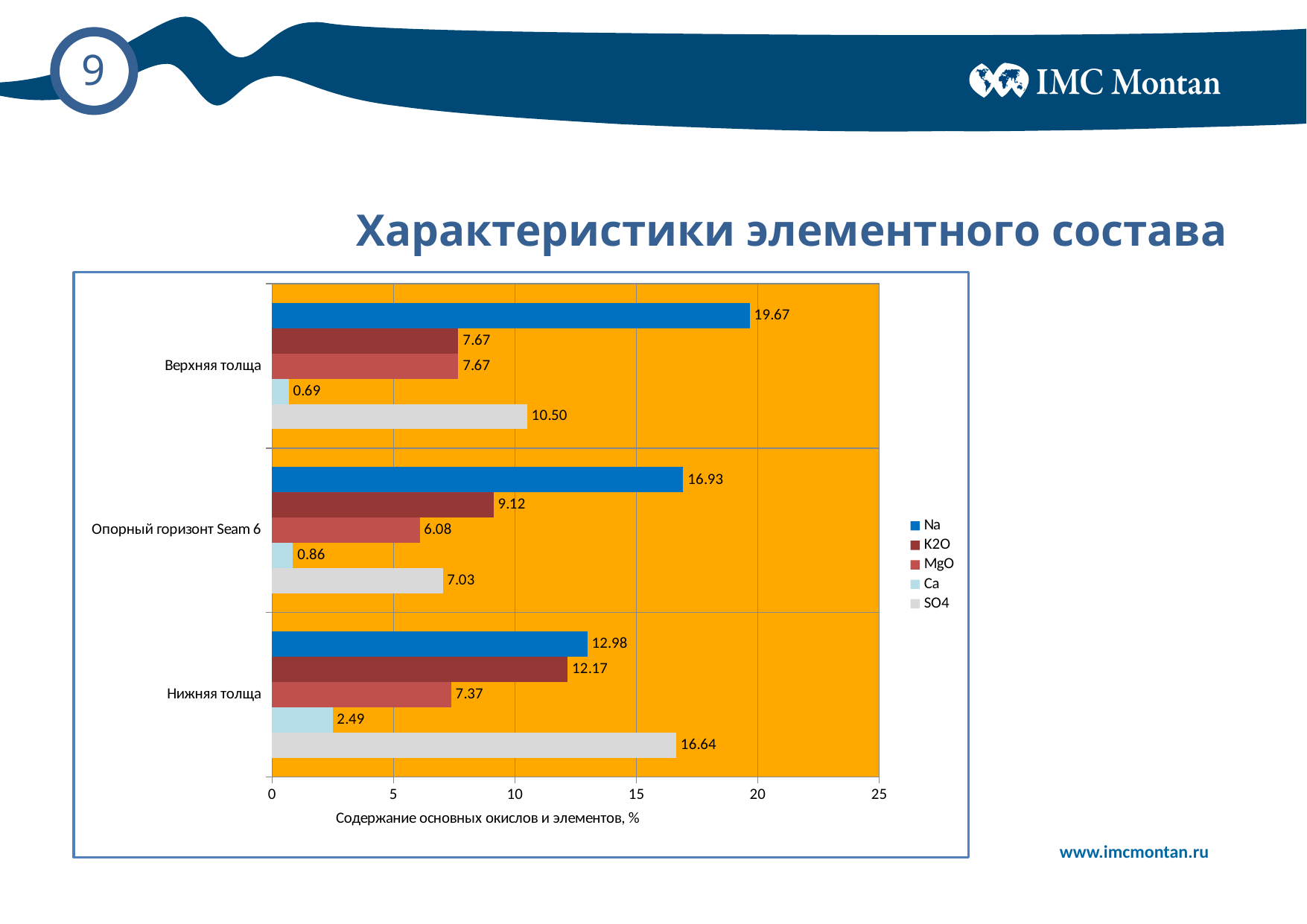
Which category has the highest Na value? Верхняя толща What kind of chart is shown on the slide? Bar chart What is the Ca value for Опорный горизонт Seam 6? 0.86 Which category has the lowest Ca value? Верхняя толща What is the difference between the Na and SO4 values for Верхняя толща? 9.17 How many categories are shown on the y axis? 3 What is the x-axis title of the chart? Содержание основных окислов и элементов, % What is the SO4 value for Нижняя толща? 16.64 Which is larger for Опорный горизонт Seam 6: K2O or MgO? K2O How many series does the legend list? 5 What is the K2O value for Нижняя толща? 12.17 What is the Na value for Верхняя толща? 19.67